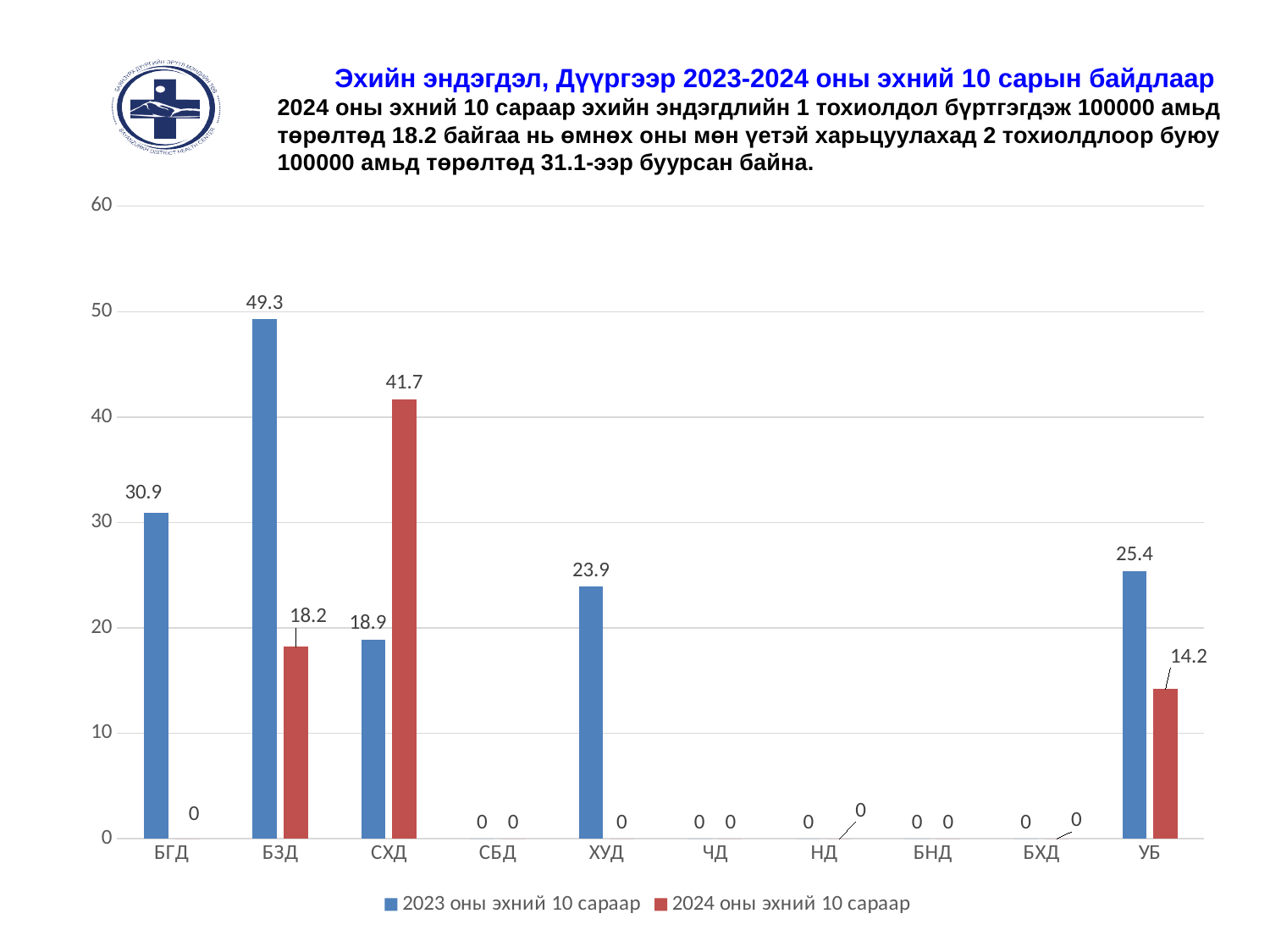
What is the value for УБ in the series '2024 оны эхний 10 сараар'? 14.2 What is the value for СХД in the series '2024 оны эхний 10 сараар'? 41.7 What is the difference between the 2023 and 2024 values for БЗД? 31.1 For СХД, which series has the larger value: '2023 оны эхний 10 сараар' or '2024 оны эхний 10 сараар'? 2024 оны эхний 10 сараар How many categories are shown on the x axis? 10 What is the value for БЗД in the series '2023 оны эхний 10 сараар'? 49.3 Which category has the highest value in the series '2024 оны эхний 10 сараар'? СХД What colour are the bars for the series '2024 оны эхний 10 сараар'? red Is the value for БГД in the series '2023 оны эхний 10 сараар' greater or less than 30? greater Which category has the highest value in the series '2023 оны эхний 10 сараар'? БЗД How many series does the legend list? 2 What type of chart is shown on the slide? bar chart